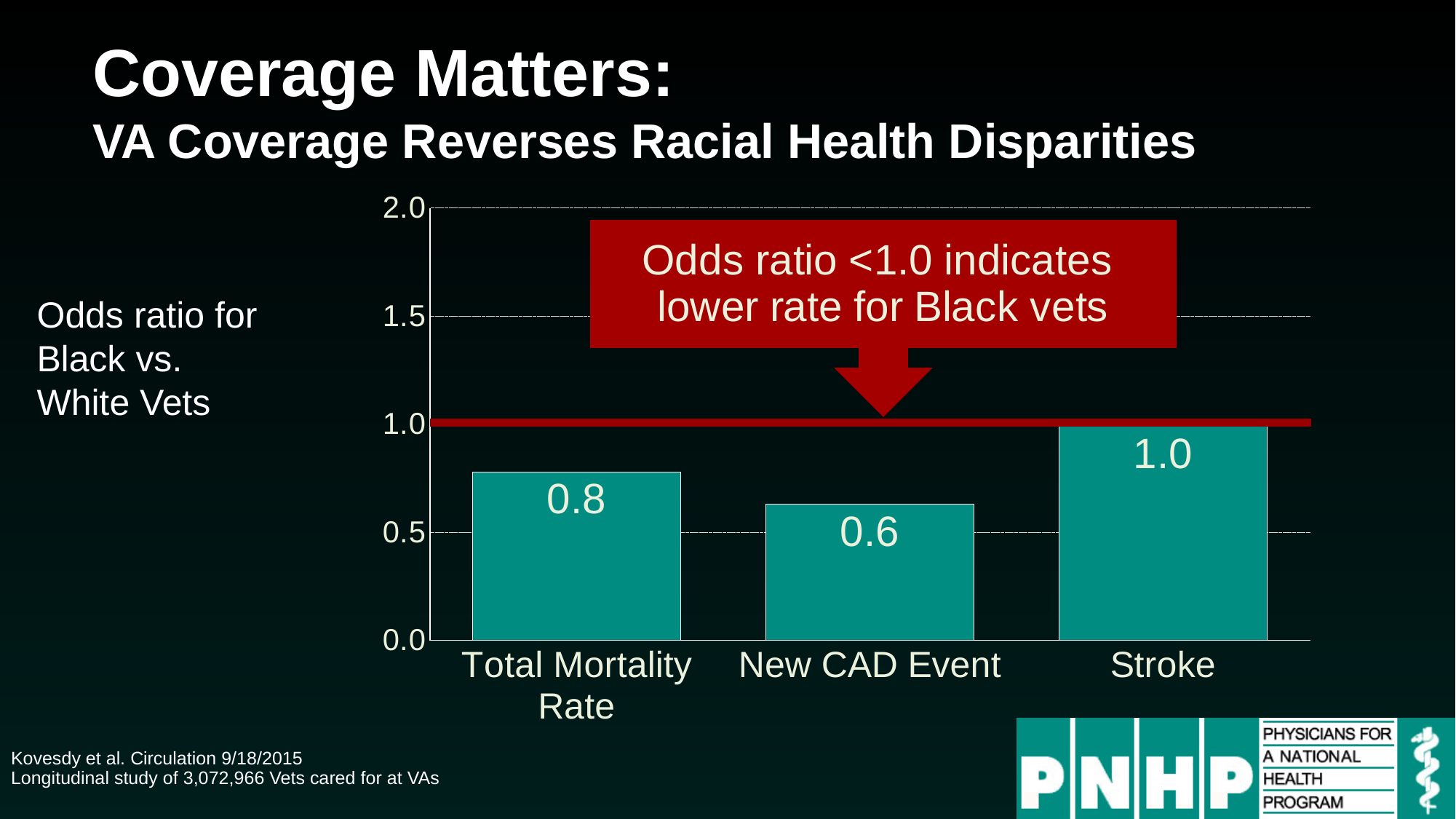
What is the difference between the odds ratios for Stroke and New CAD Event? 0.4 What is the odds ratio for Total Mortality Rate? 0.8 Which category has the lowest odds ratio? New CAD Event What kind of chart is shown on the slide? bar chart Which category has the highest odds ratio? Stroke How many categories are shown on the x axis? 3 What does the red callout box on the chart say? Odds ratio <1.0 indicates lower rate for Black vets Is the value for Total Mortality Rate greater or less than 1.0? less What is the difference between the odds ratios for Total Mortality Rate and New CAD Event? 0.2 Which is larger, the odds ratio for Total Mortality Rate or for New CAD Event? Total Mortality Rate What is the odds ratio for New CAD Event? 0.6 What is the odds ratio for Stroke? 1.0